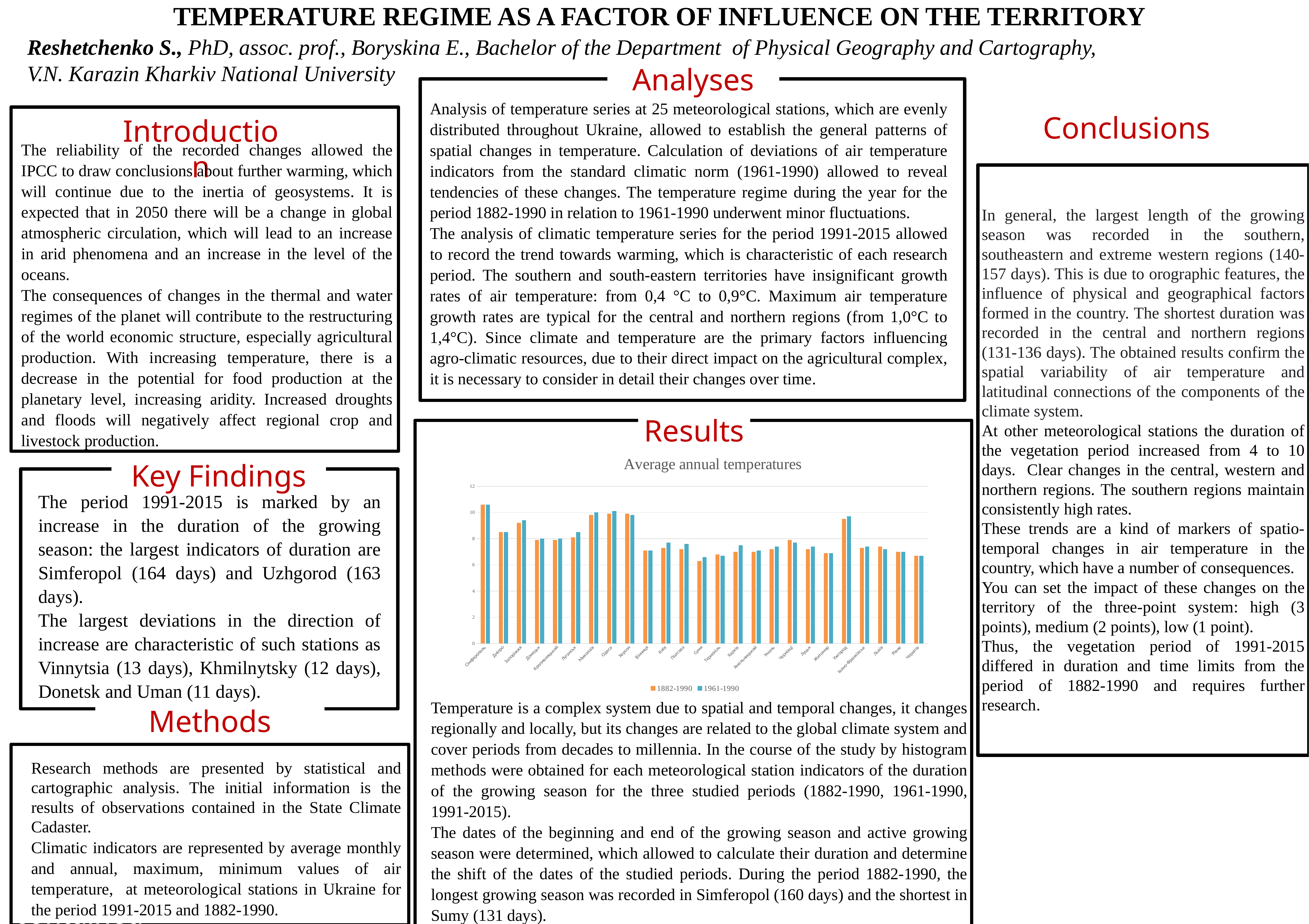
In the Average annual temperatures chart, is the 1961-1990 value for Ужгород greater or less than 8? greater What kind of chart is shown in the Results section? bar chart In the Average annual temperatures chart, is the 1882-1990 value for Сімферополь greater or less than 10? greater In the Average annual temperatures chart, is the 1882-1990 value for Вінниця greater or less than 8? less In the Average annual temperatures chart, which is larger for 1961-1990: Одеса or Чернігів? Одеса What are the two series named in the legend of the Average annual temperatures chart? 1882-1990 and 1961-1990 How many series does the legend of the Average annual temperatures chart list? 2 In the Average annual temperatures chart, which is larger for 1882-1990: Сімферополь or Київ? Сімферополь What is the title of the chart in the Results section? Average annual temperatures In the Average annual temperatures chart, which station has the highest value? Сімферополь